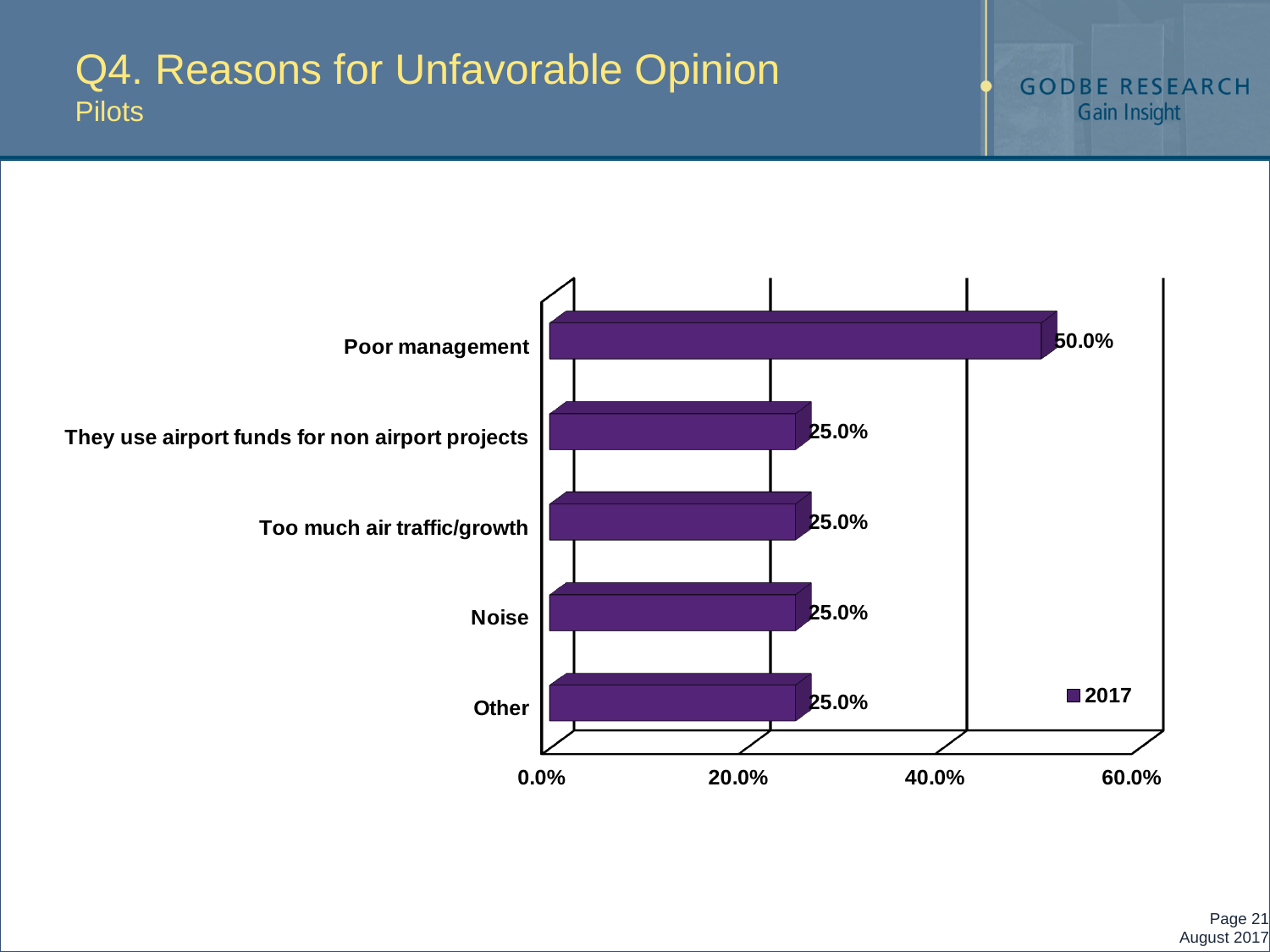
Which is larger, the value for Poor management or the value for Noise? Poor management What is the difference between the values for Poor management and Too much air traffic/growth? 25.0% What is the value for Noise? 25.0% What is the value for Poor management? 50.0% What is the value for Other? 25.0% Which category has the highest value? Poor management How many series does the legend list? 1 What kind of chart is shown on the slide? Bar chart Is the value for Poor management greater or less than 40.0%? greater What is the value for They use airport funds for non airport projects? 25.0% How many categories are shown in the chart? 5 Is the value for Other greater or less than 40.0%? less